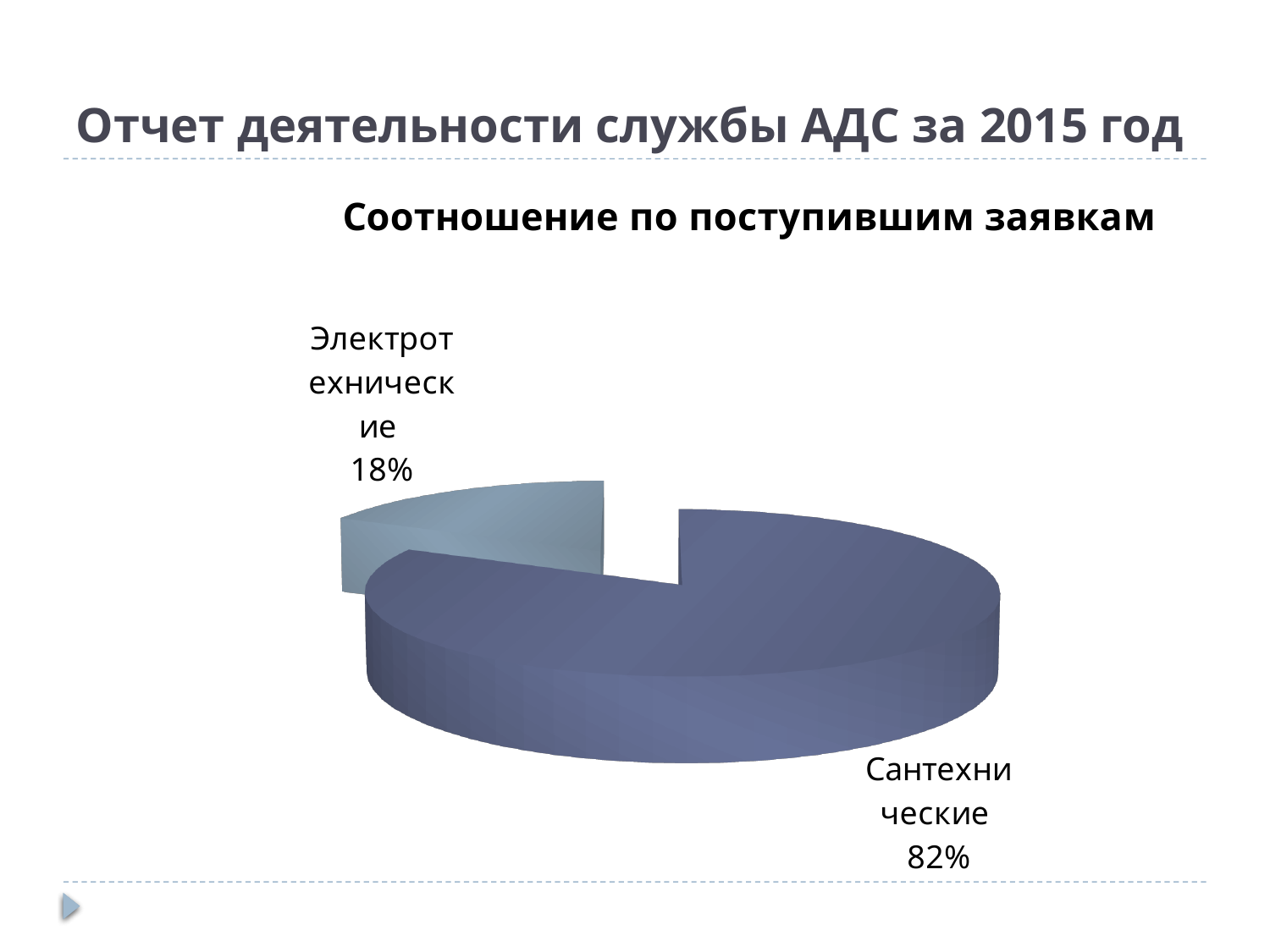
Which category has the smallest share of the pie? Электротехнические Which category has the largest share of the pie? Сантехнические What is the difference in percentage points between Сантехнические and Электротехнические? 64 How many slices does the pie chart have? 2 Which slice is pulled out (exploded) from the pie? Электротехнические What share of the pie is Сантехнические? 82% What share of the pie is Электротехнические? 18% Is the share for Сантехнические greater or less than 80%? greater Which is larger, the share for Сантехнические or for Электротехнические? Сантехнические What kind of chart is shown on the slide? pie chart What is the title of the chart? Соотношение по поступившим заявкам Is the share for Электротехнические greater or less than 20%? less